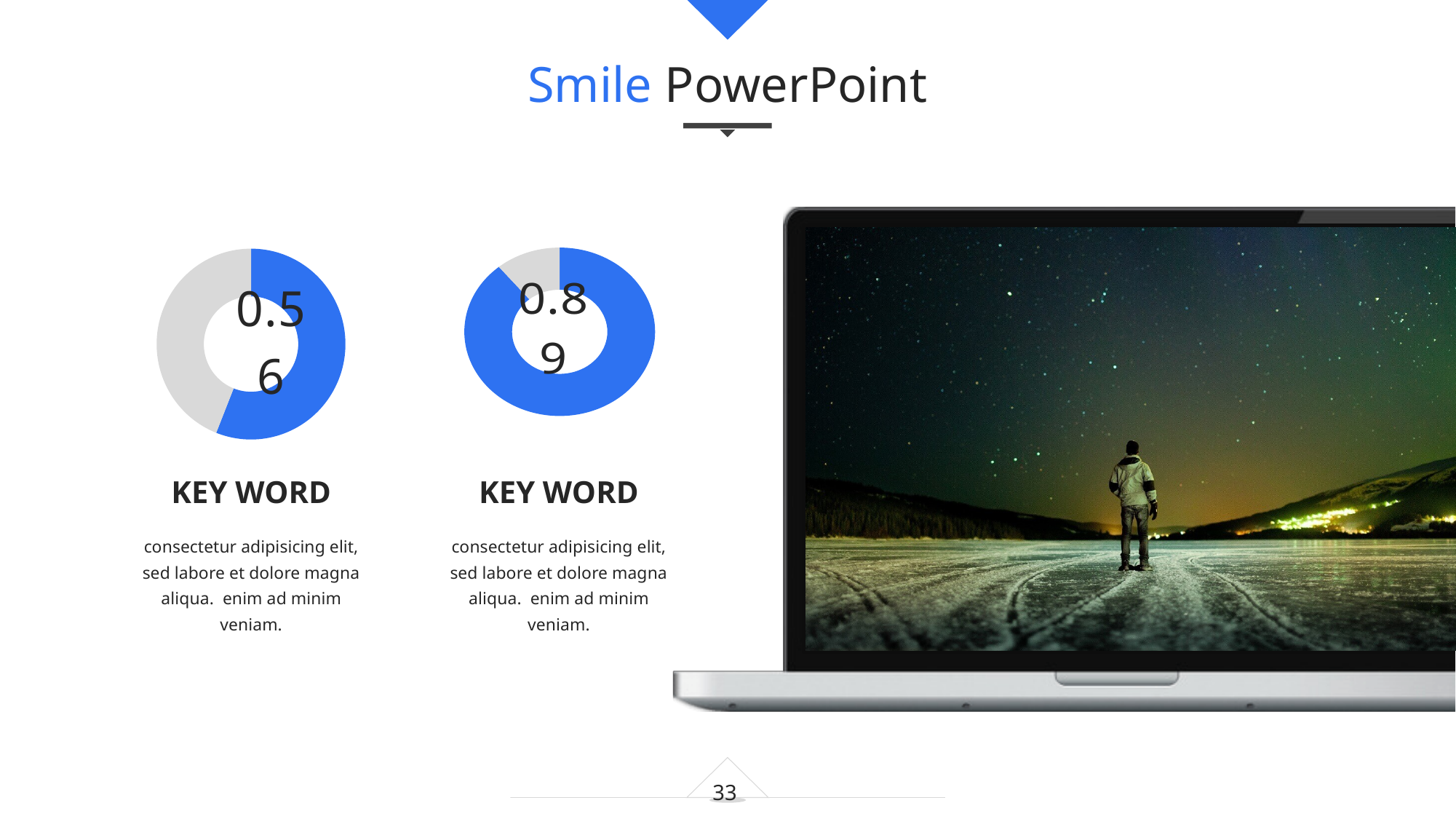
In the left donut chart, is the blue segment larger or smaller than the grey segment? larger What label appears beneath each donut chart? KEY WORD What kind of chart is used on the left side of the slide? donut chart In the right donut chart, which segment is smaller, the blue one or the grey one? the grey one Which donut chart shows the larger value, the left one or the right one? the right one What is the difference between the value in the right donut chart and the value in the left donut chart? 0.33 How many donut charts are shown on the slide? 2 What value is printed in the centre of the left donut chart? 0.56 What colour is the filled (highlighted) portion of each donut chart? blue Is the value shown in the left donut chart greater or less than 0.5? greater What value is printed in the centre of the right donut chart? 0.89